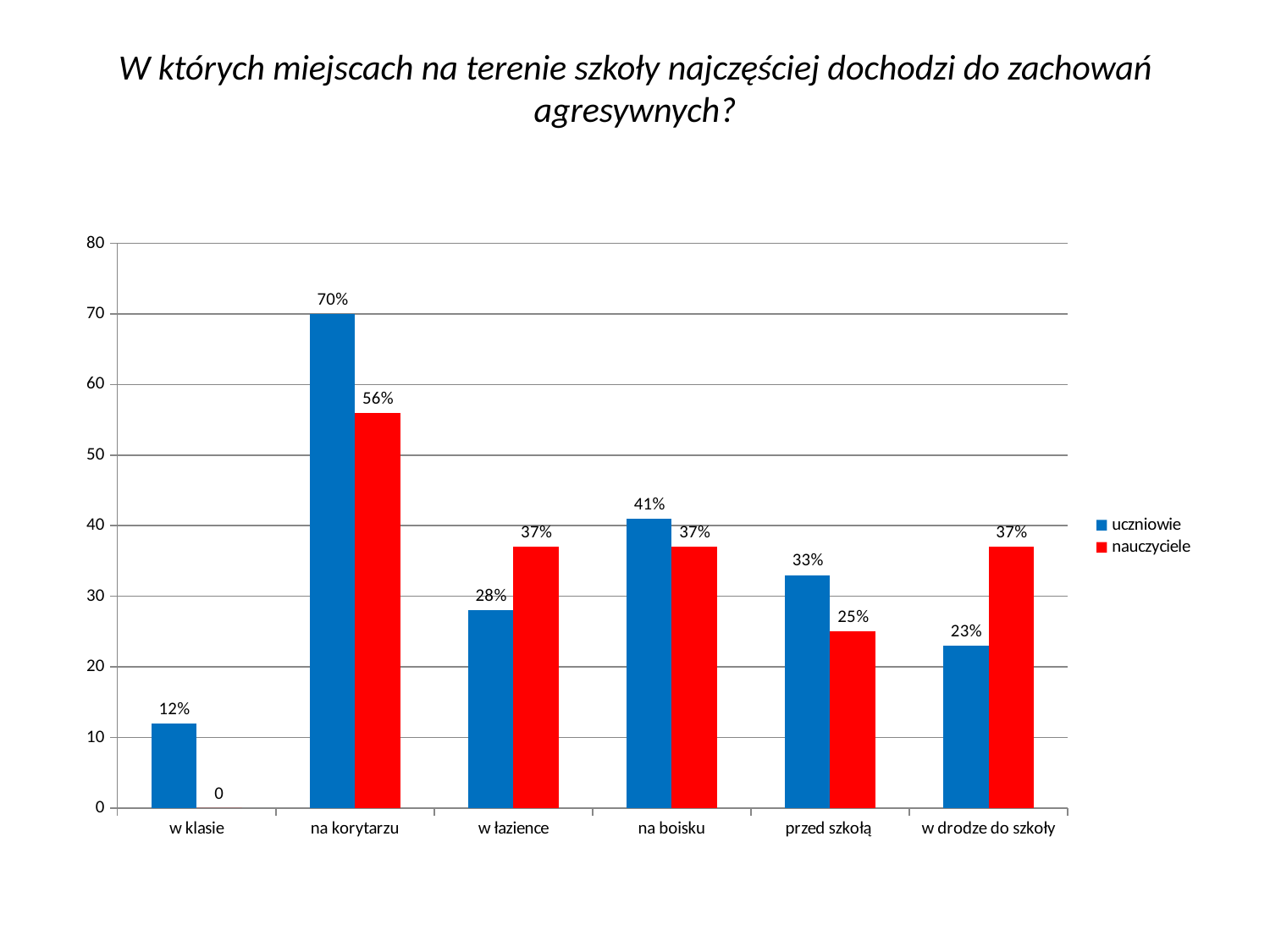
Which is larger for w drodze do szkoły: the uczniowie value or the nauczyciele value? nauczyciele What is the value for nauczyciele in the category przed szkołą? 25% What is the difference between the uczniowie and nauczyciele values for na korytarzu? 14% What kind of chart is shown on the slide? bar chart How many series does the legend list? 2 What is the value for uczniowie in the category na korytarzu? 70% Is the value for uczniowie in na boisku greater or less than 40? greater Which colour represents the nauczyciele series? red What is the value for nauczyciele in the category w klasie? 0 How many categories are shown on the x axis? 6 Which category has the highest value for uczniowie? na korytarzu Which category has the lowest value for nauczyciele? w klasie